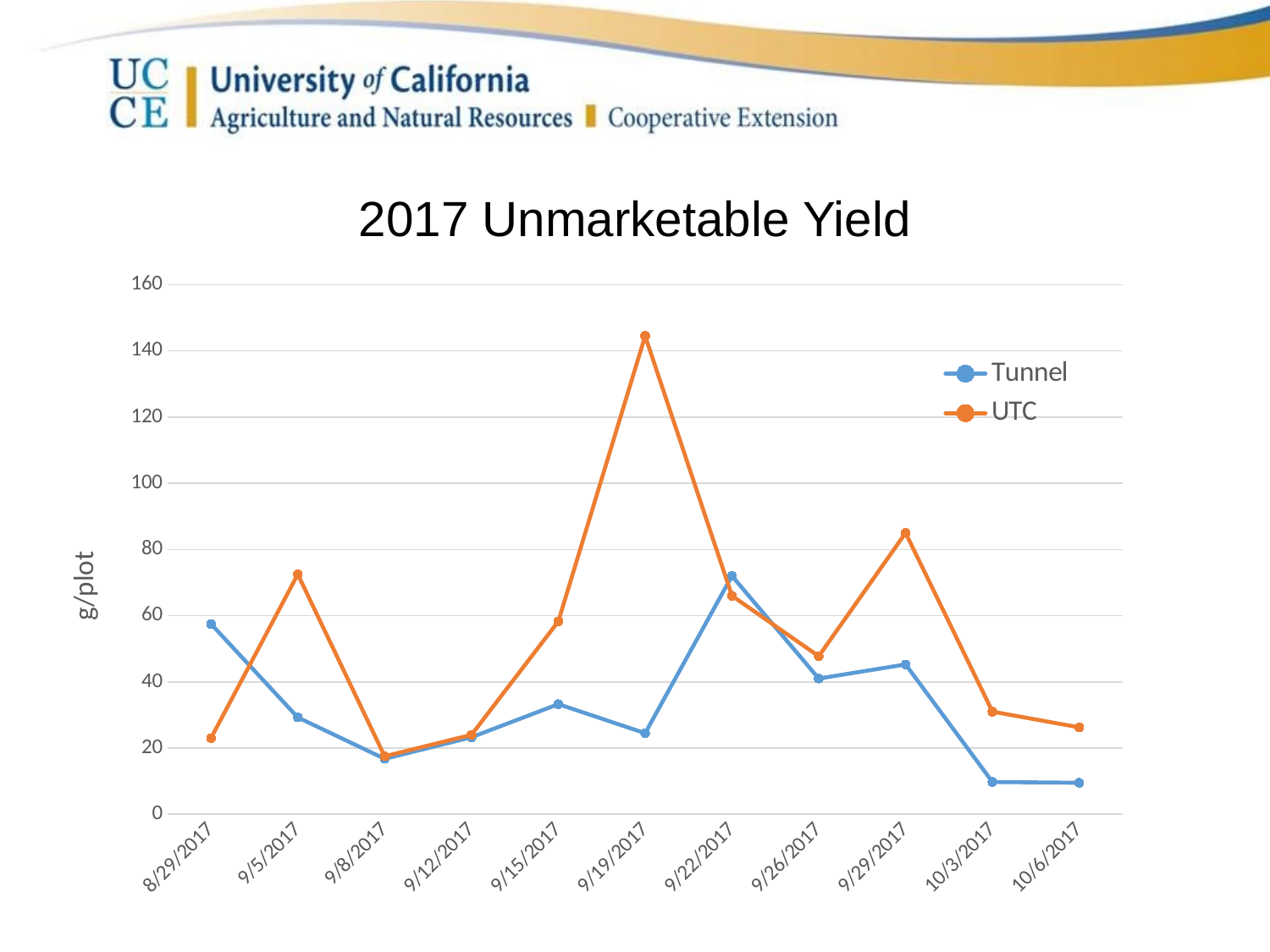
Is the value for Tunnel on 10/3/2017 greater or less than 20? less How many series does the legend list? 2 On which date does the UTC series reach its lowest value? 9/8/2017 On which date does the Tunnel series reach its highest value? 9/22/2017 On which date does the UTC series reach its highest value? 9/19/2017 How many dates are shown along the x axis? 11 On 8/29/2017, which series has the larger value, Tunnel or UTC? Tunnel What kind of chart is shown on the slide? Line chart Is the value for UTC on 9/19/2017 greater or less than 120? greater Does the Tunnel series rise or fall from 9/29/2017 to 10/6/2017? Fall What is the label on the y axis? g/plot Is the value for UTC on 9/5/2017 greater or less than 60? greater